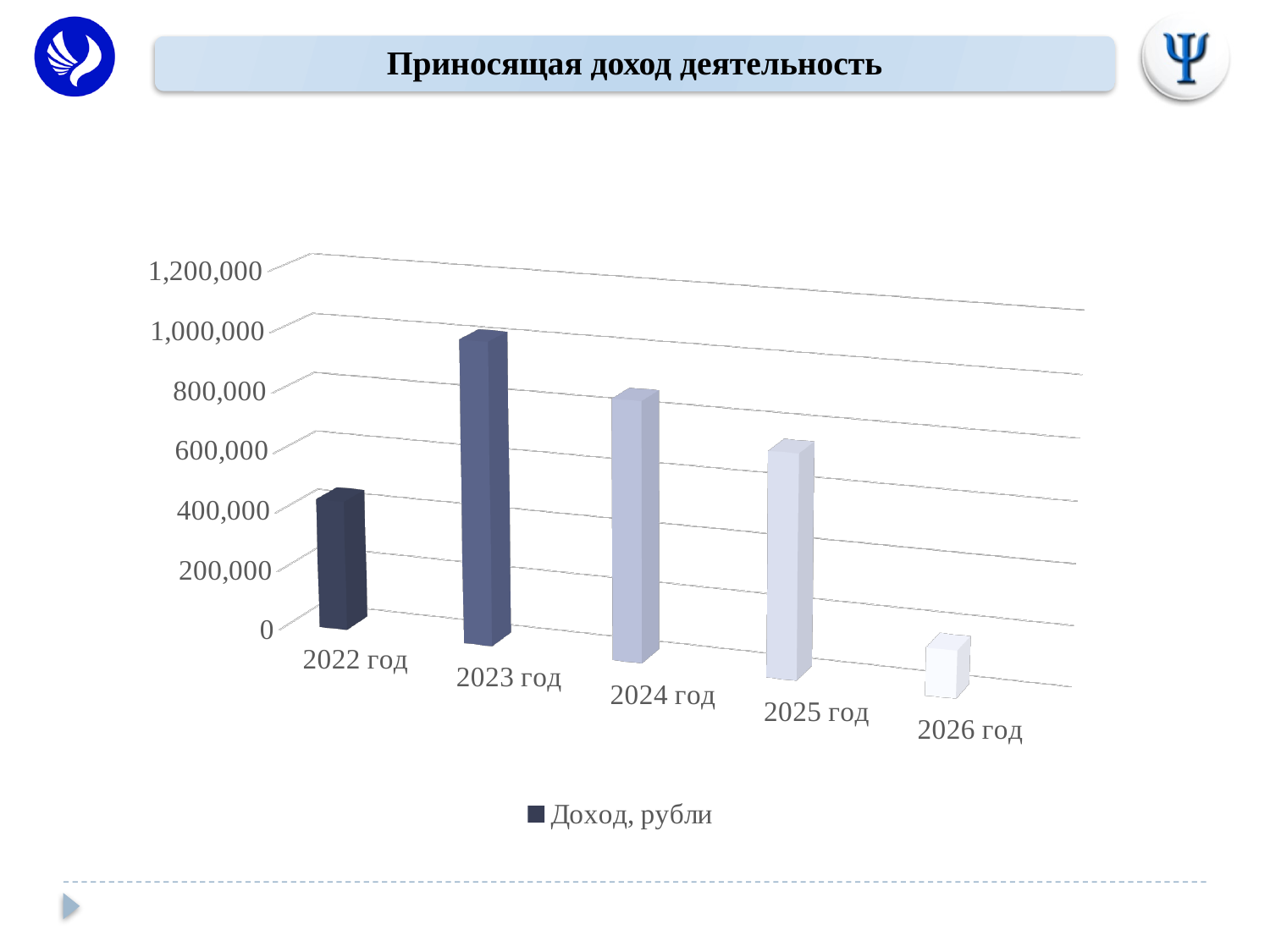
What is the name of the series shown in the chart legend? Доход, рубли Do the values rise or fall from 2023 год to 2026 год? fall How many series does the chart legend list? 1 Which year has the lowest value in the chart? 2026 год Which is larger, the value for 2024 год or the value for 2025 год? 2024 год Which year has the highest value in the chart? 2023 год Is the value for 2022 год greater or less than 600,000? less How many years (categories) are shown on the x axis of the chart? 5 Which is larger, the value for 2022 год or the value for 2025 год? 2025 год Is the value for 2023 год greater or less than 800,000? greater What kind of chart is shown on the slide? bar chart Is the value for 2026 год greater or less than 200,000? less